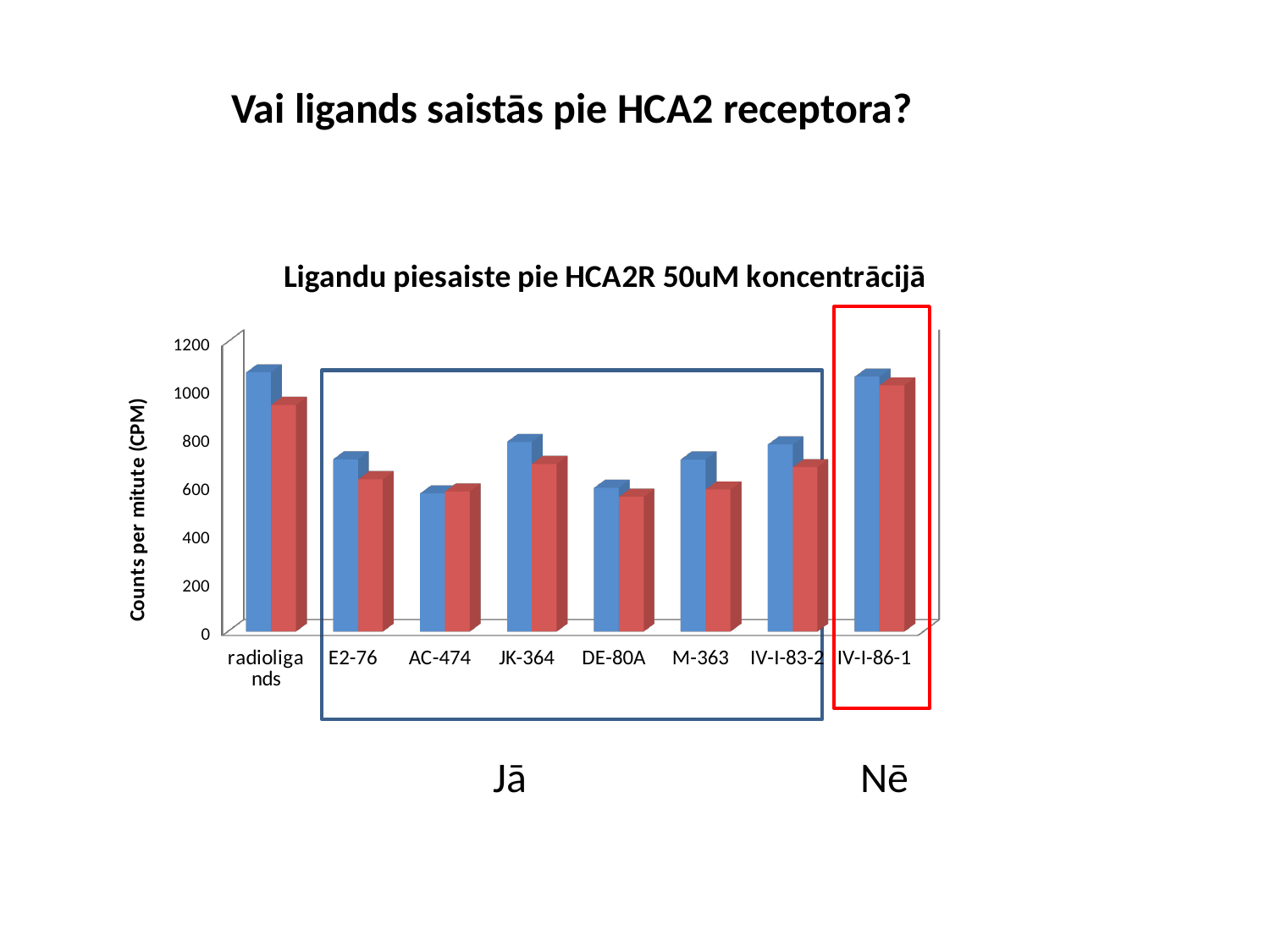
What is the label of the vertical axis? Counts per mitute (CPM) Which is larger, the red bar for IV-I-86-1 or the red bar for IV-I-83-2? IV-I-86-1 Which is larger, the blue bar for JK-364 or the blue bar for DE-80A? JK-364 Which is larger, the blue bar for radioligands or the blue bar for E2-76? radioligands How many categories are shown on the x axis of the chart? 8 Is the blue bar for AC-474 greater or less than 800? less What kind of chart is shown on the slide? bar chart What is the title of the chart? Ligandu piesaiste pie HCA2R 50uM koncentrācijā Is the blue bar for IV-I-86-1 greater or less than 1000? greater Is the blue bar for radioligands greater or less than 1000? greater